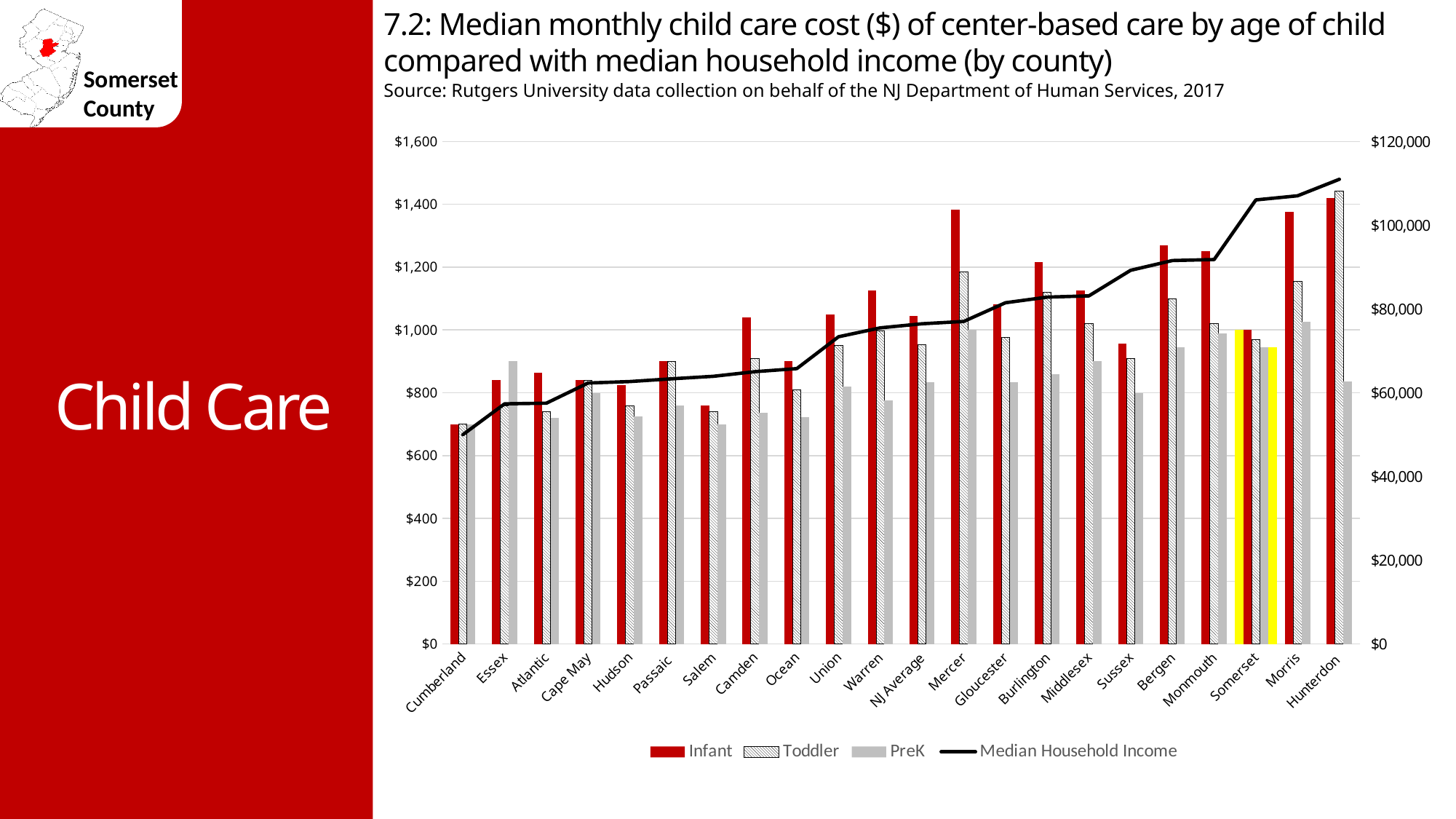
Which category has the lowest Infant value? Cumberland Is the Infant value for Cumberland greater or less than $800? less Which is larger, the Infant value for Mercer or the Infant value for Somerset? Mercer Is the Infant value for Somerset greater or less than $1,200? less Is the Toddler value for Hunterdon greater or less than $1,400? greater Which category has the highest Toddler value? Hunterdon How many counties/categories are shown along the x axis? 22 How many series does the legend list? 4 What kind of chart is this? Bar chart with a line Which county's bars are highlighted in yellow? Somerset Does the Median Household Income line generally rise or fall from left to right? rise